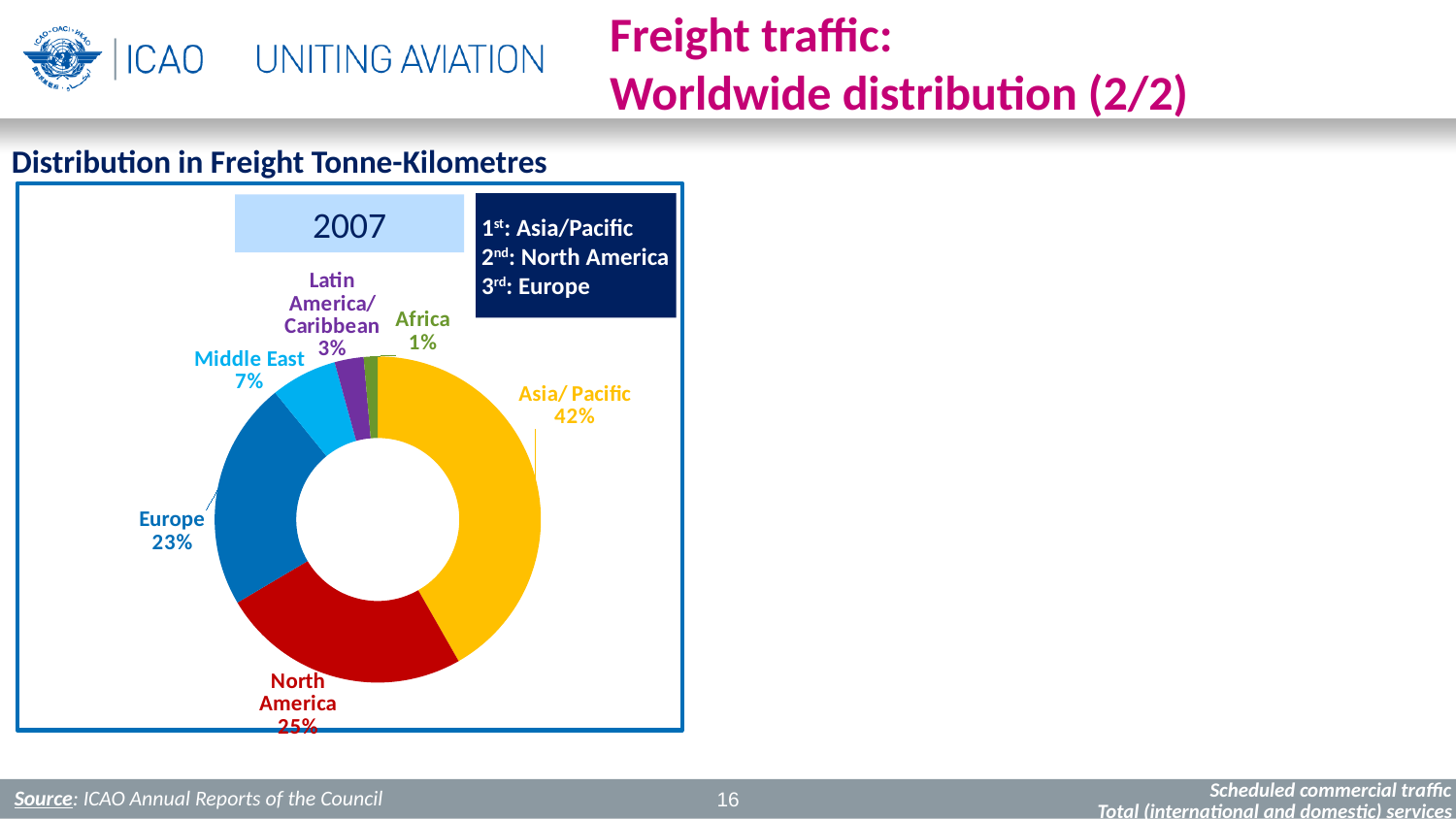
Which has a larger share, Europe or the Middle East? Europe What percentage is shown for the Middle East? 7% What percentage is shown for Latin America/Caribbean? 3% What percentage is shown for Europe? 23% How many regions are shown in the chart? 6 What percentage is shown for North America? 25% What is the difference in percentage points between Asia/Pacific and North America? 17 percentage points Which year does the chart refer to? 2007 What kind of chart is shown on the slide? Pie chart (doughnut) What share of freight tonne-kilometres does Asia/Pacific account for in 2007? 42% Which region has the largest share of freight tonne-kilometres? Asia/Pacific Which region has the smallest share of freight tonne-kilometres? Africa